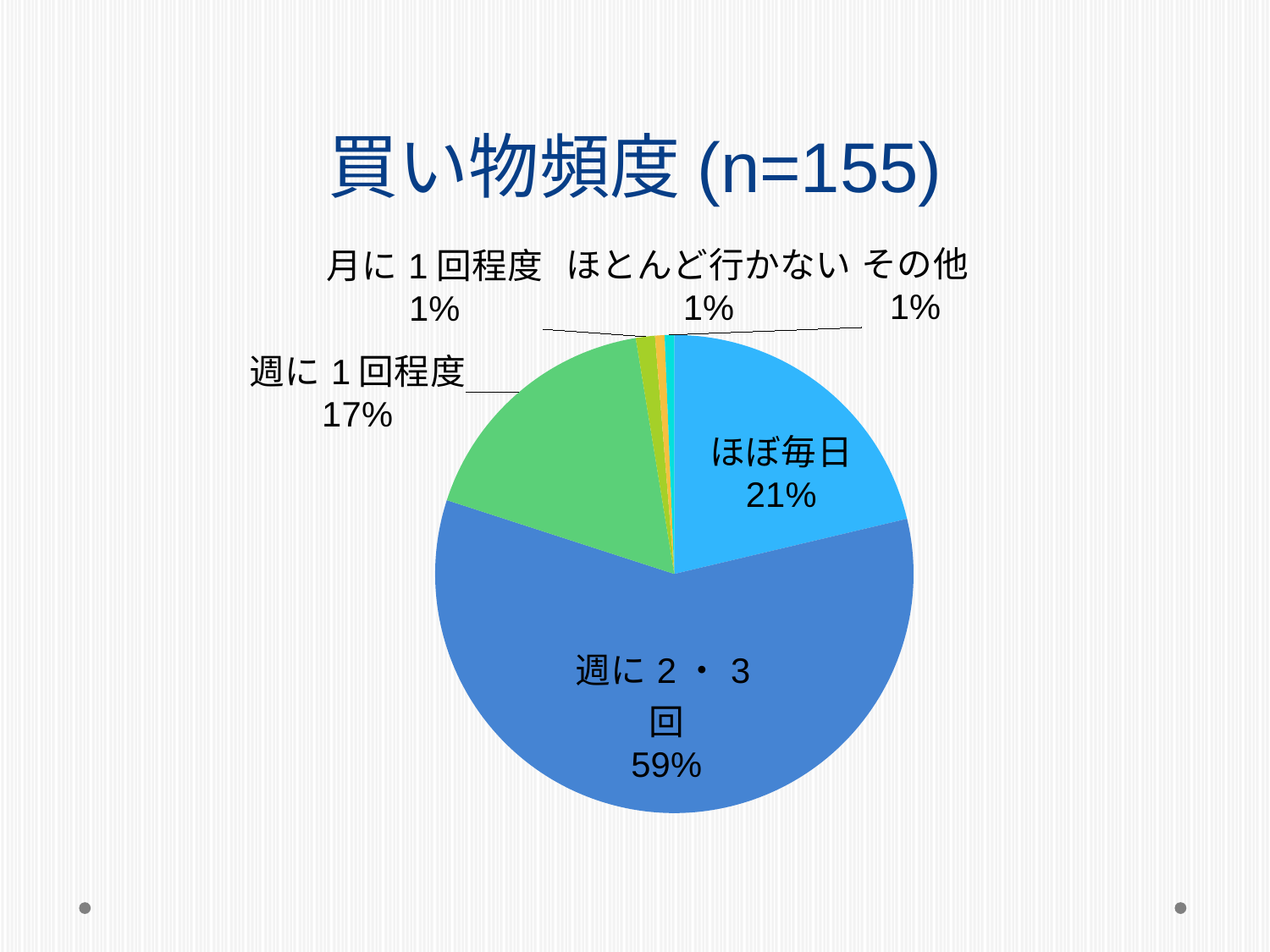
What is the combined share of ほぼ毎日 and 週に２・３回? 80% What is the title of the chart? 買い物頻度 (n=155) Which is larger, the share for ほぼ毎日 or the share for 週に１回程度? ほぼ毎日 What share of the pie does 週に２・３回 take? 59% Which category has the largest slice of the pie? 週に２・３回 What is the value shown for 月に１回程度? 1% What is the value shown for 週に１回程度? 17% How many categories are shown in the pie chart? 6 What is the difference between the shares of ほぼ毎日 and 週に１回程度? 4% What kind of chart is shown on the slide? Pie chart What is the value shown for ほぼ毎日? 21% What is the difference between the shares of 週に２・３回 and ほぼ毎日? 38%